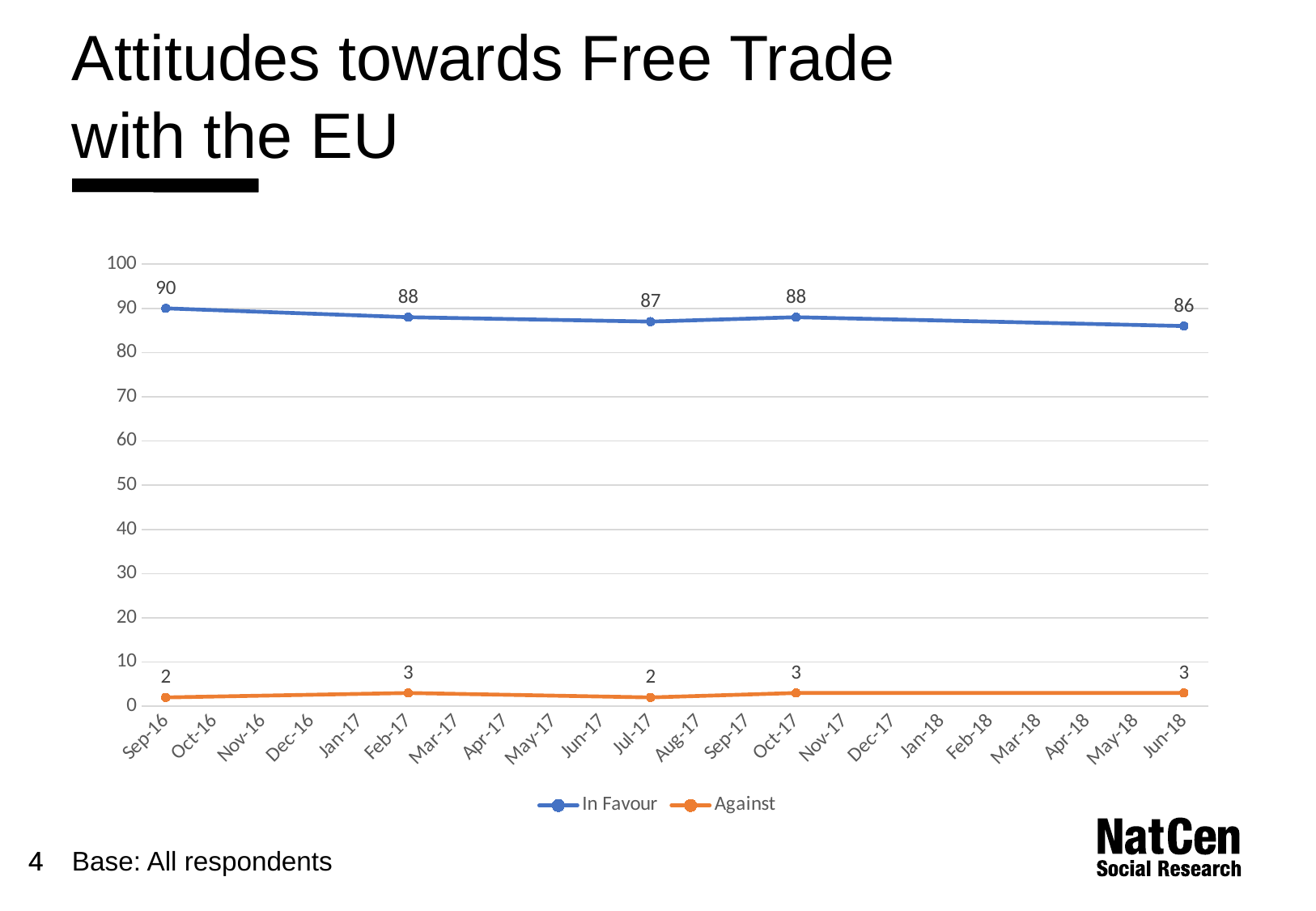
What is the value for Against in Jul-17? 2 What kind of chart is shown on the slide? Line chart Which is larger in Jul-17, the In Favour value or the Against value? In Favour What is the difference between the In Favour and Against values in Oct-17? 85 In which month is the In Favour value highest? Sep-16 What is the value for In Favour in Jun-18? 86 What is the value for In Favour in Sep-16? 90 Is the In Favour value in Feb-17 greater or less than 80? greater In which month is the In Favour value lowest? Jun-18 How many series does the legend list? 2 What is the value for Against in Feb-17? 3 Does the In Favour line rise or fall overall from Sep-16 to Jun-18? Fall